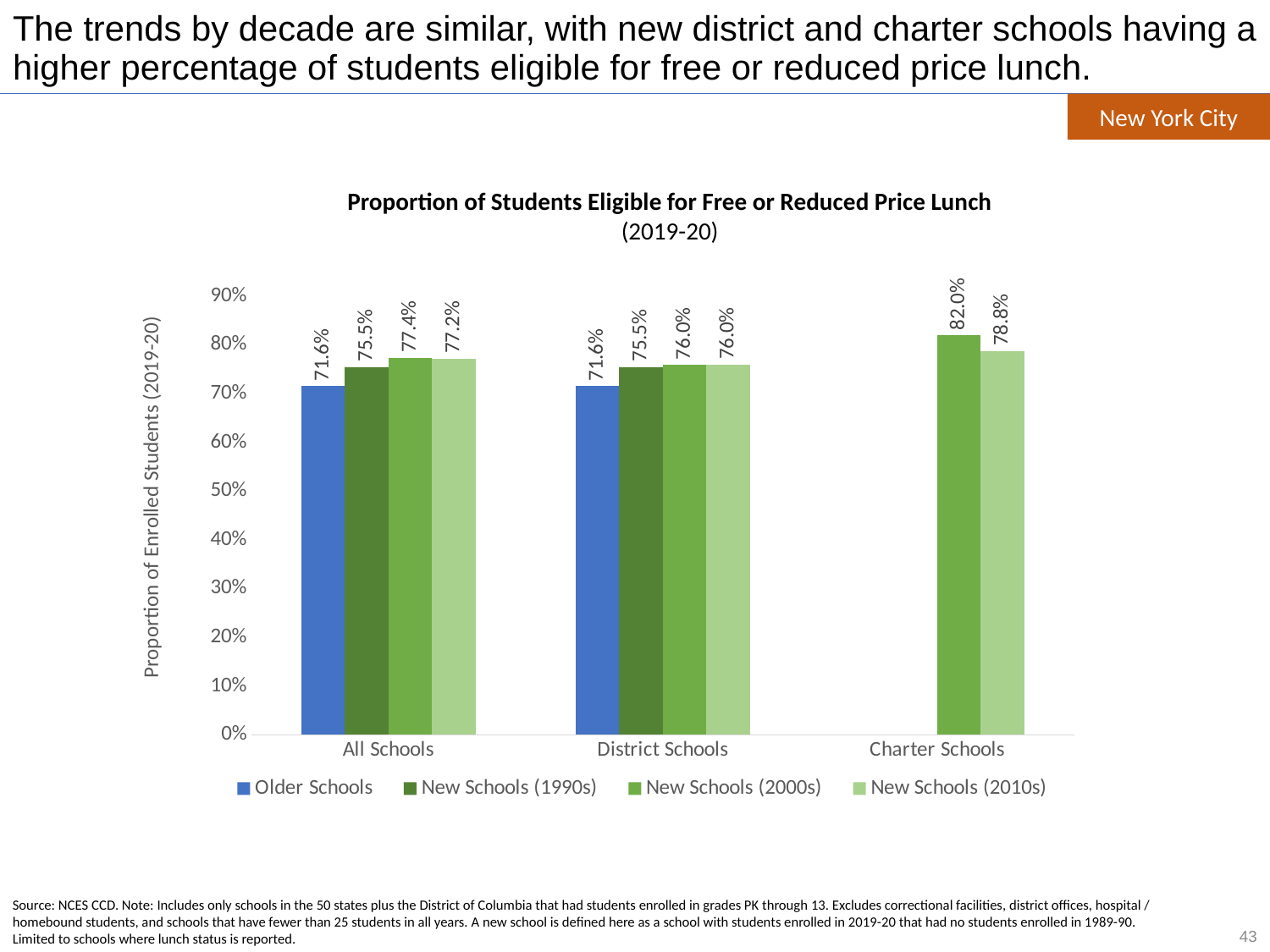
What is the value for New Schools (2000s) in the Charter Schools category? 82.0% Which series has the highest value in the Charter Schools category? New Schools (2000s) Which is larger: New Schools (2000s) for Charter Schools or New Schools (2010s) for Charter Schools? New Schools (2000s) for Charter Schools What is the difference between New Schools (2000s) and Older Schools in the All Schools category? 5.8 percentage points What is the value for Older Schools in the All Schools category? 71.6% What kind of chart is shown on the slide? Bar chart How many series does the legend list? 4 What is the value for New Schools (1990s) in the All Schools category? 75.5% What is the title of the chart? Proportion of Students Eligible for Free or Reduced Price Lunch (2019-20) Which series has the lowest value in the All Schools category? Older Schools What is the value for New Schools (2010s) in the District Schools category? 76.0% How many categories are shown on the x axis? 3